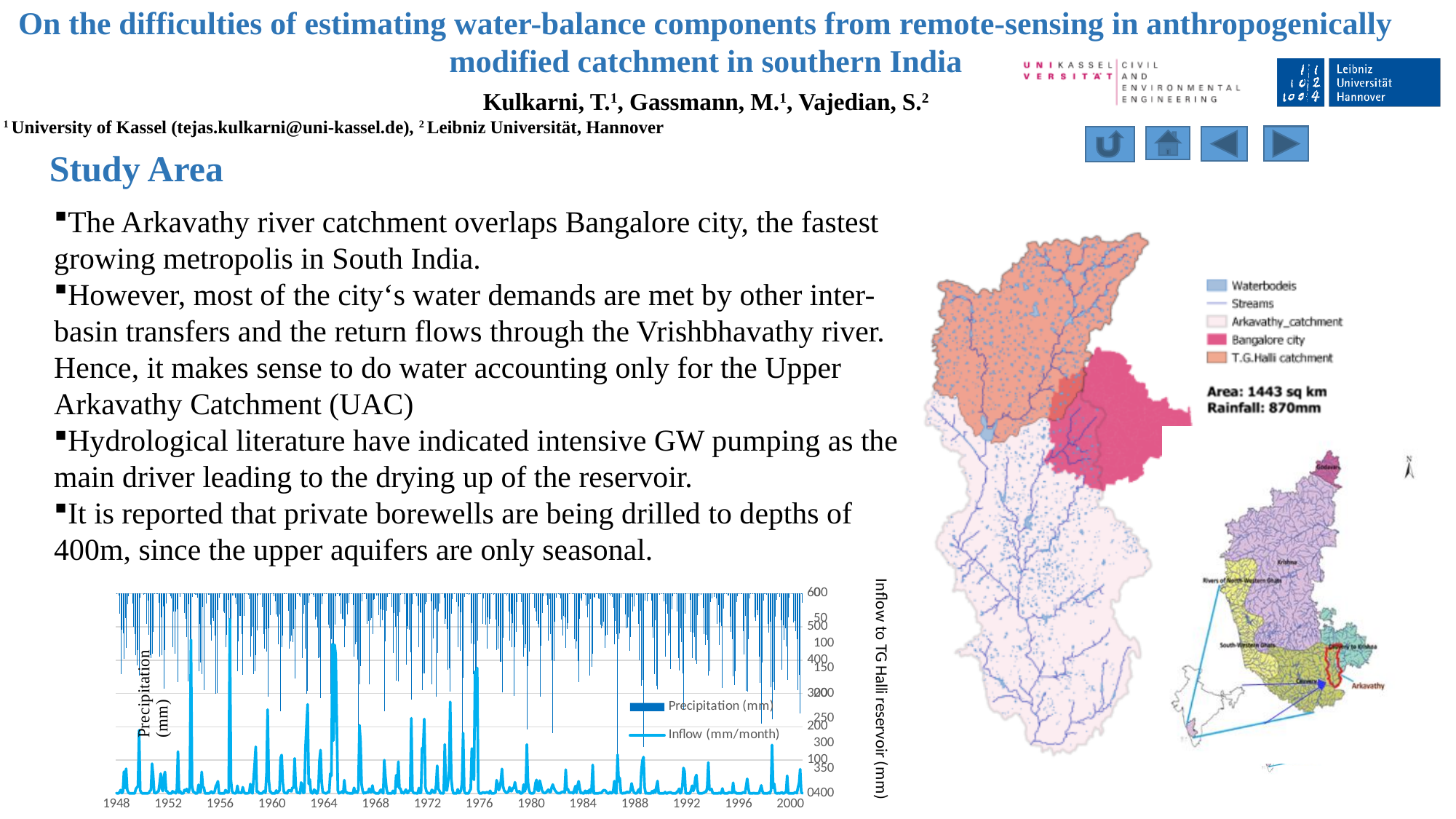
What is the label of the left-hand vertical axis of the chart? Precipitation (mm) What is the first year shown on the x axis of the chart? 1948 Which series in the chart is drawn as bars? Precipitation (mm) What are the two series named in the chart's legend? Precipitation (mm) and Inflow (mm/month) What is the highest tick value shown on the inflow axis of the chart? 600 What is the last year labelled on the x axis of the chart? 2000 What kind of chart is shown at the bottom left of the slide? A combined bar and line chart How many series does the legend of the chart list? 2 What is the highest tick value shown on the precipitation axis of the chart? 400 What is the label of the right-hand vertical axis of the chart? Inflow to TG Halli reservoir (mm)